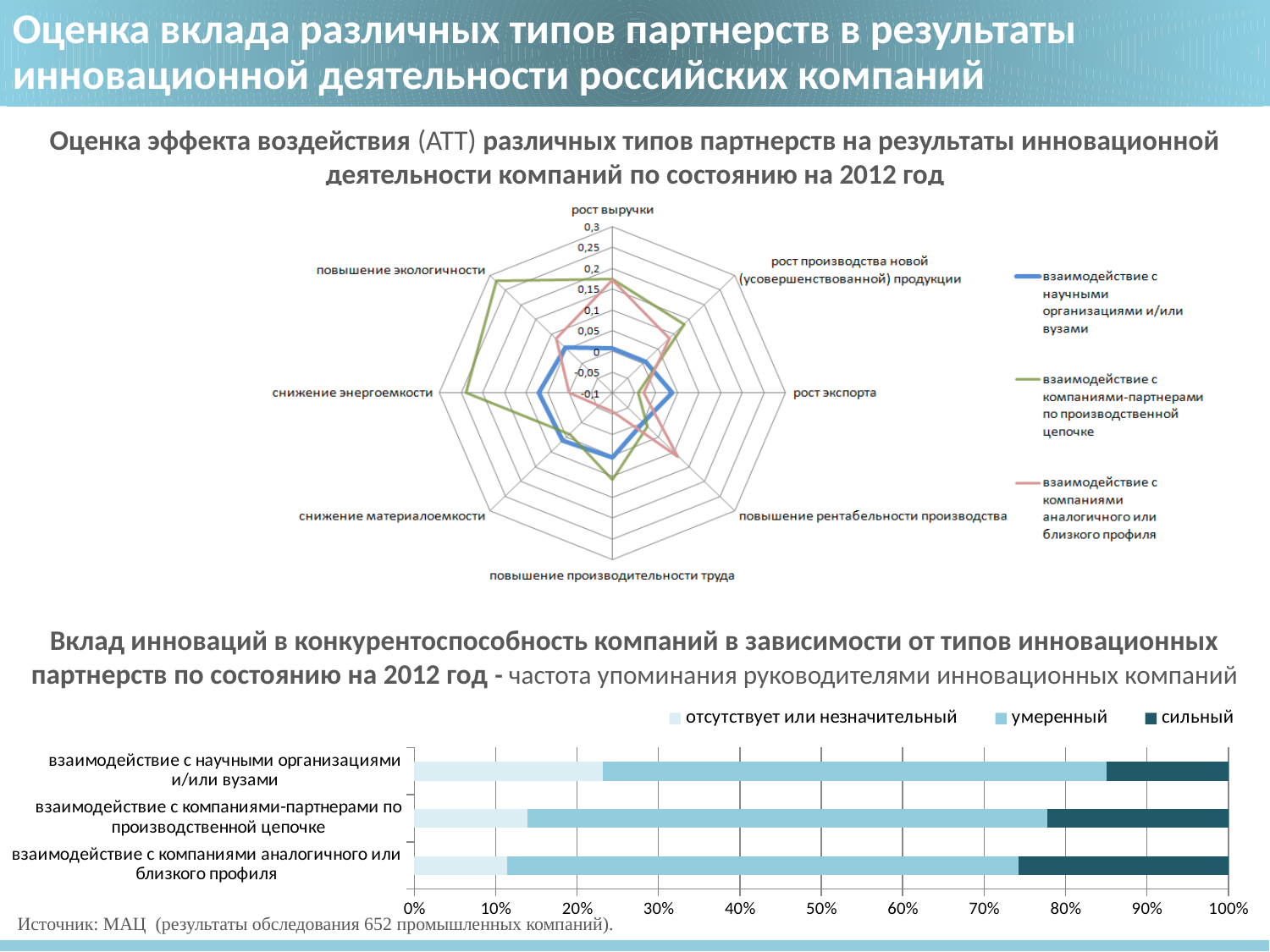
In the top (radar) chart, which series has the highest value for 'повышение рентабельности производства'? взаимодействие с компаниями аналогичного или близкого профиля What kind of chart is the bottom chart on the slide? stacked bar chart How many series does the legend of the bottom chart list? 3 How many series does the legend of the top (radar) chart list? 3 In the top (radar) chart, which series has the highest value for 'повышение экологичности'? взаимодействие с компаниями-партнерами по производственной цепочке In the bottom chart, which category has the larger 'сильный' share: 'взаимодействие с научными организациями и/или вузами' or 'взаимодействие с компаниями аналогичного или близкого профиля'? взаимодействие с компаниями аналогичного или близкого профиля In the bottom chart, is the 'отсутствует или незначительный' share for 'взаимодействие с компаниями аналогичного или близкого профиля' greater or less than 20%? less In the top (radar) chart, is the value of 'взаимодействие с компаниями-партнерами по производственной цепочке' for 'снижение энергоемкости' greater or less than 0.1? greater What kind of chart is the top chart on the slide? radar chart In the bottom chart, which category has the larger 'отсутствует или незначительный' share: 'взаимодействие с научными организациями и/или вузами' or 'взаимодействие с компаниями аналогичного или близкого профиля'? взаимодействие с научными организациями и/или вузами How many categories (axes) does the top (radar) chart have? 8 How many categories does the bottom chart show? 3